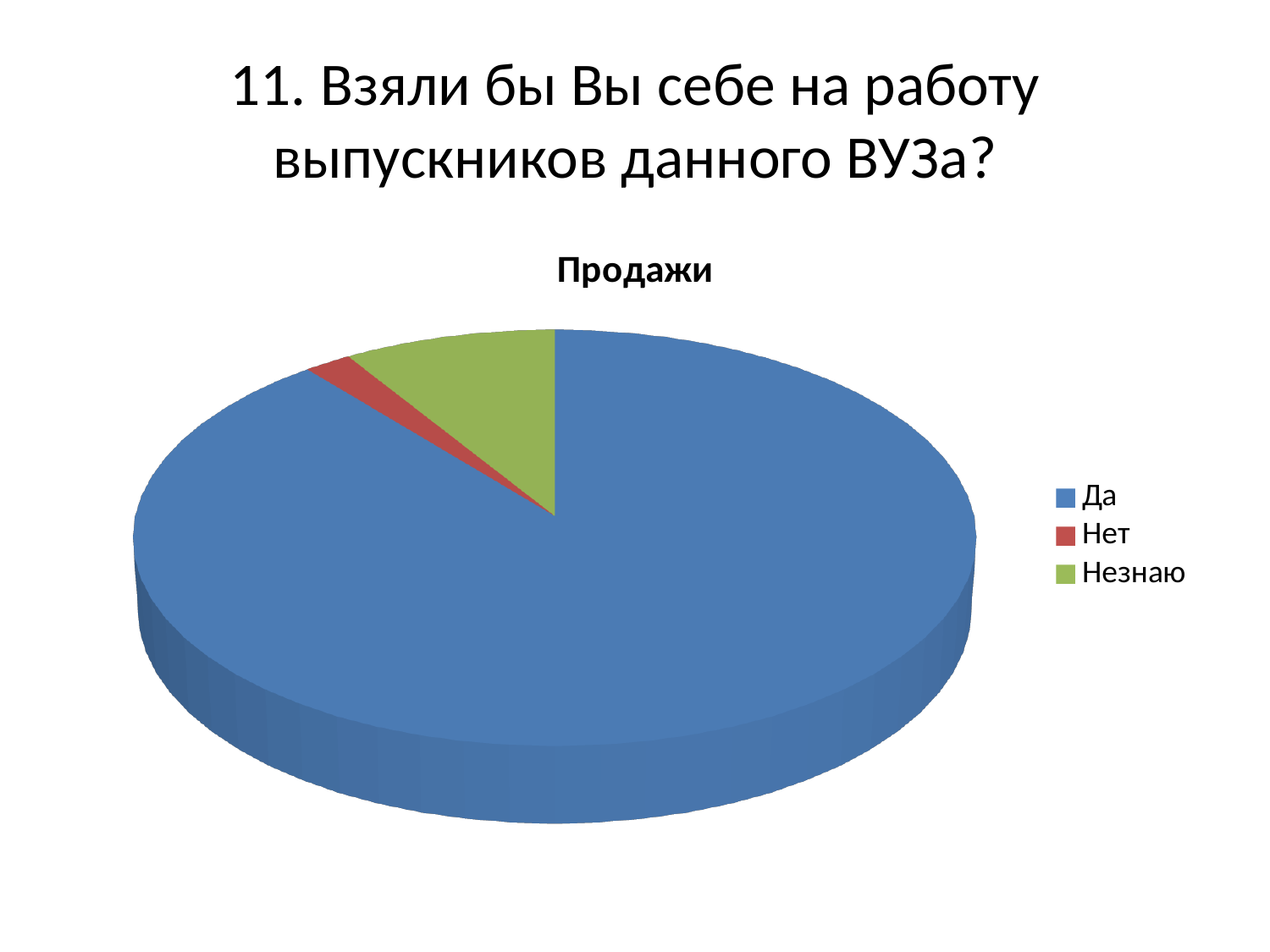
How many entries does the legend of the pie chart list? 3 What is the title of the pie chart? Продажи Which slice is larger, Да or Незнаю? Да Which slice is larger, Незнаю or Нет? Незнаю Which category has the largest slice in the pie chart? Да How many slices does the pie chart have? 3 Which category has the smallest slice in the pie chart? Нет What kind of chart is shown on the slide? pie chart What colour is the slice for Незнаю in the pie chart? green